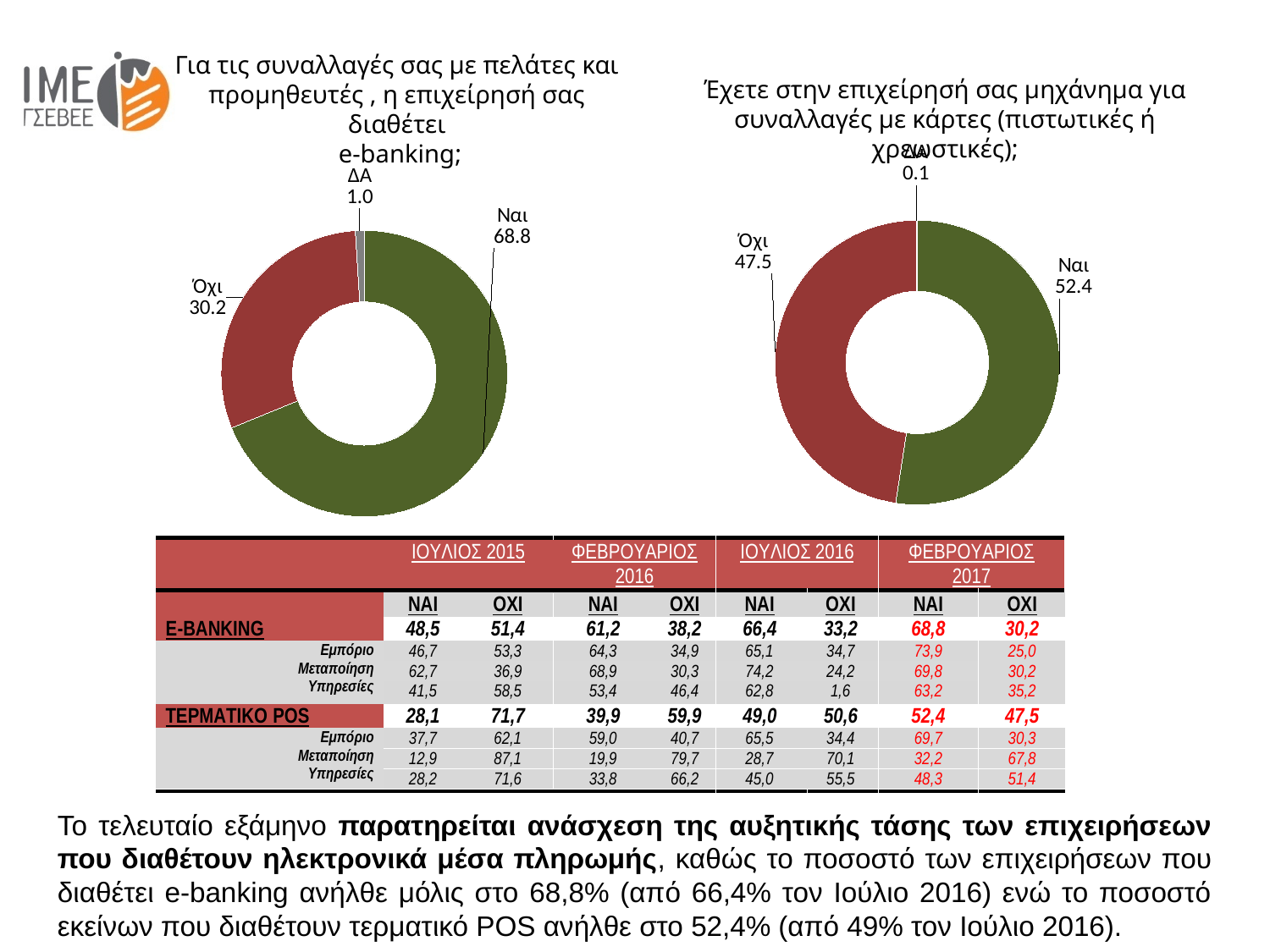
In the right doughnut chart (card terminal), what is the value for Ναι? 52.4 In the left doughnut chart (e-banking), what is the value for Ναι? 68.8 In the right doughnut chart (card terminal), what is the value for ΔΑ? 0.1 What type of chart is used on the left of the slide for e-banking? Doughnut chart In the right doughnut chart (card terminal), which category has the smallest share? ΔΑ In the right doughnut chart (card terminal), what is the value for Όχι? 47.5 In the left doughnut chart (e-banking), what is the value for ΔΑ? 1.0 In the left doughnut chart (e-banking), which category has the largest share? Ναι How many categories are shown in the left doughnut chart (e-banking)? 3 In the left doughnut chart (e-banking), what is the value for Όχι? 30.2 In the right doughnut chart (card terminal), what is the difference between Ναι and Όχι? 4.9 In the left doughnut chart (e-banking), what is the difference between Ναι and Όχι? 38.6